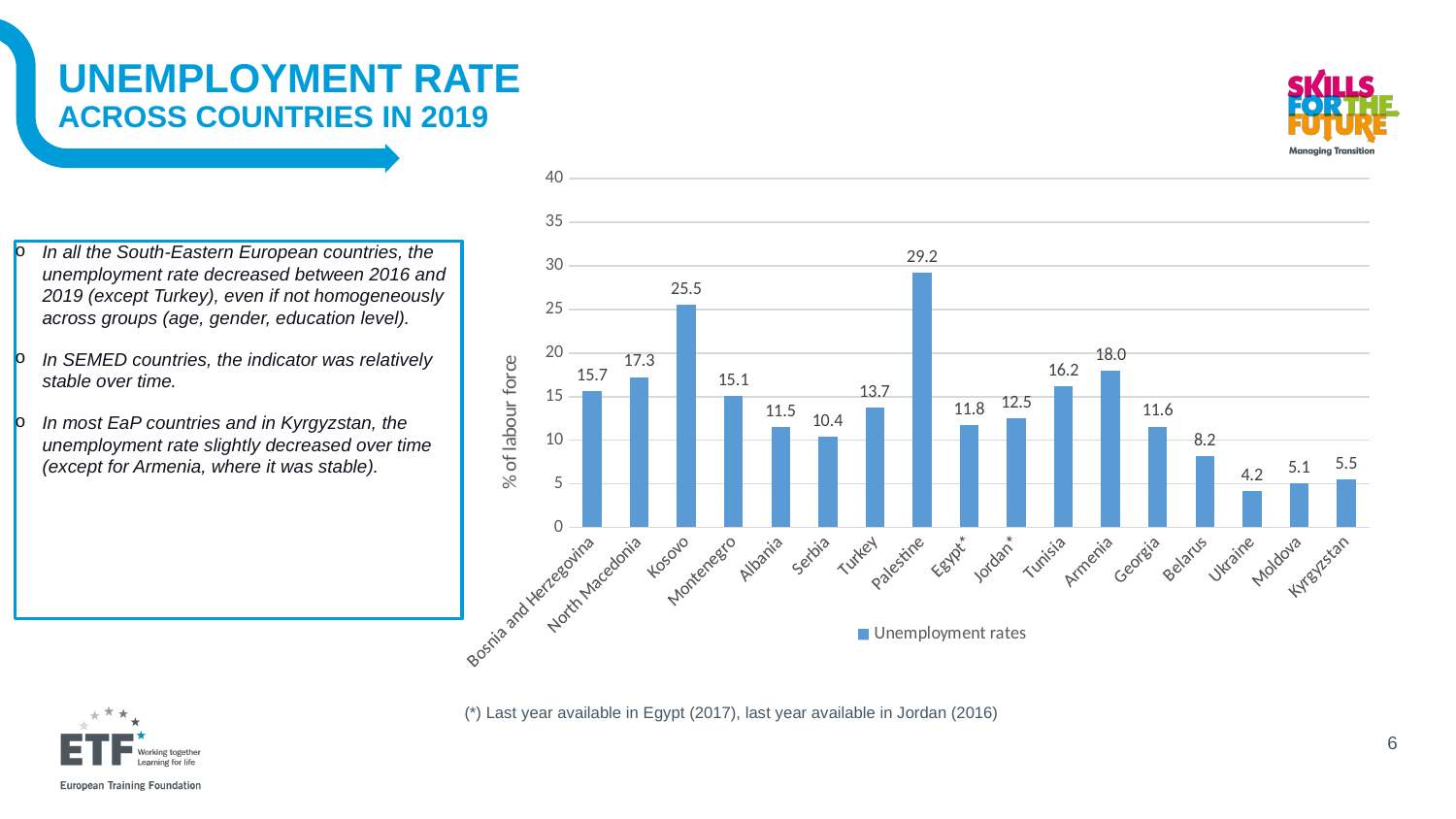
What is the unemployment rate for Ukraine? 4.2 How many countries are shown in the chart? 17 What is the difference between the unemployment rates of Palestine and Kosovo? 3.7 What is the unemployment rate for Kosovo? 25.5 How many series does the legend list? 1 Which has a higher unemployment rate, Armenia or Georgia? Armenia What kind of chart is shown on the slide? bar chart Is the unemployment rate for Belarus greater or less than 10? less What is the unemployment rate for Tunisia? 16.2 Which country has the lowest unemployment rate? Ukraine Which country has the highest unemployment rate? Palestine What is the label of the y axis? % of labour force